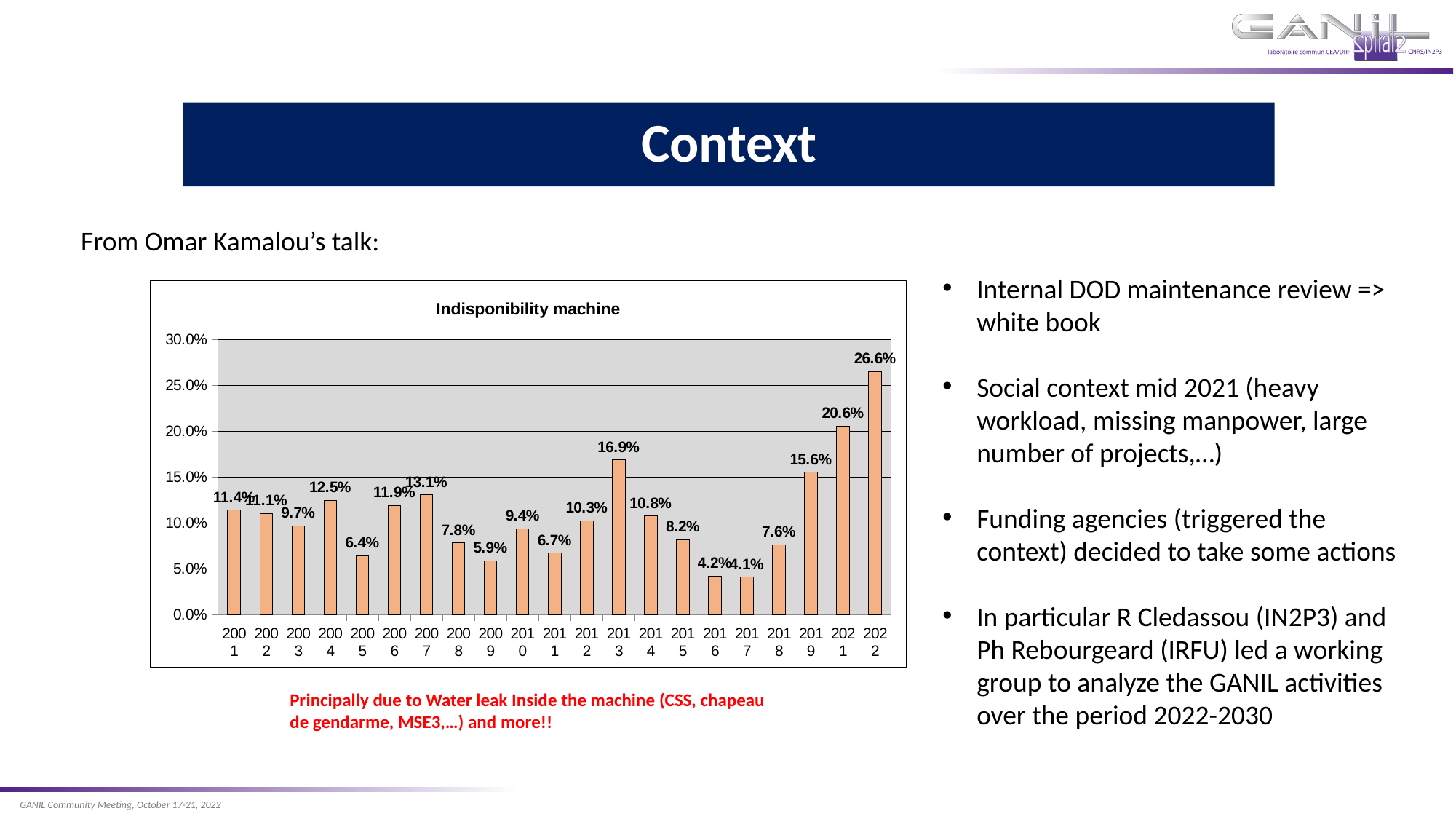
Which year has the highest value in the Indisponibility machine chart? 2022 What is the difference between the values for 2019 and 2018 in the Indisponibility machine chart? 8.0% What is the title of the chart on the slide? Indisponibility machine What kind of chart is the Indisponibility machine chart? bar chart Which is larger in the Indisponibility machine chart, the value for 2004 or the value for 2007? 2007 What is the value for 2022 in the Indisponibility machine chart? 26.6% What is the difference between the values for 2022 and 2021 in the Indisponibility machine chart? 6.0% How many years are shown on the x axis of the Indisponibility machine chart? 21 Which year has the lowest value in the Indisponibility machine chart? 2017 What is the value for 2013 in the Indisponibility machine chart? 16.9% Is the value for 2021 in the Indisponibility machine chart greater or less than 20.0%? greater What is the value for 2005 in the Indisponibility machine chart? 6.4%